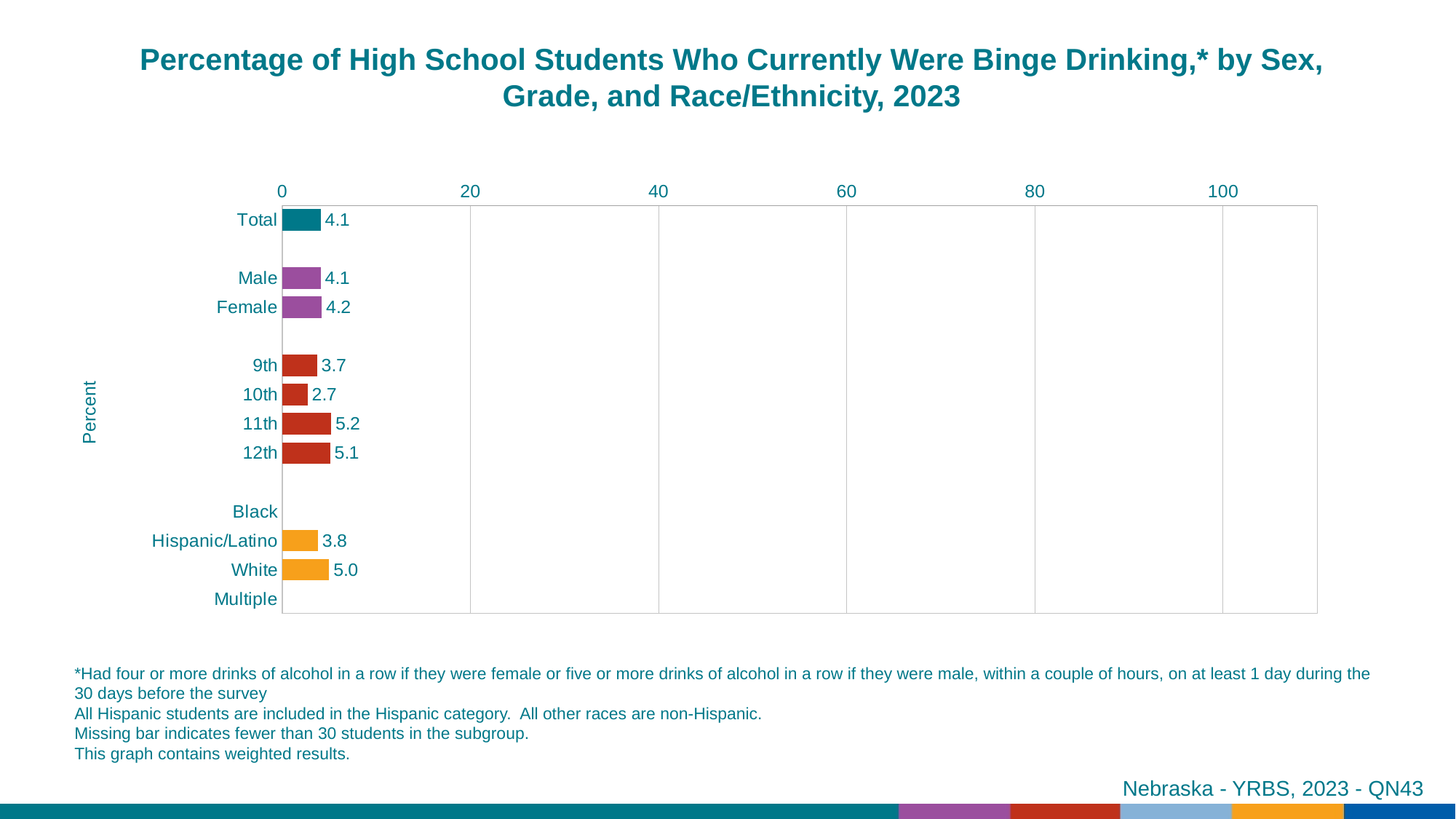
Which race/ethnicity categories have no bar shown? Black and Multiple What is the value for Female? 4.2 Which grade has the lowest value? 10th What is the difference between the values for 11th and 10th grade? 2.5 Which grade has the highest value? 11th Which is larger, the value for White or the value for Hispanic/Latino? White What is the value for 10th grade? 2.7 What is the value for White? 5.0 Is the value for 12th grade greater or less than 20? less What kind of chart is this? bar chart What is the value for Total? 4.1 How many categories have a bar plotted? 9